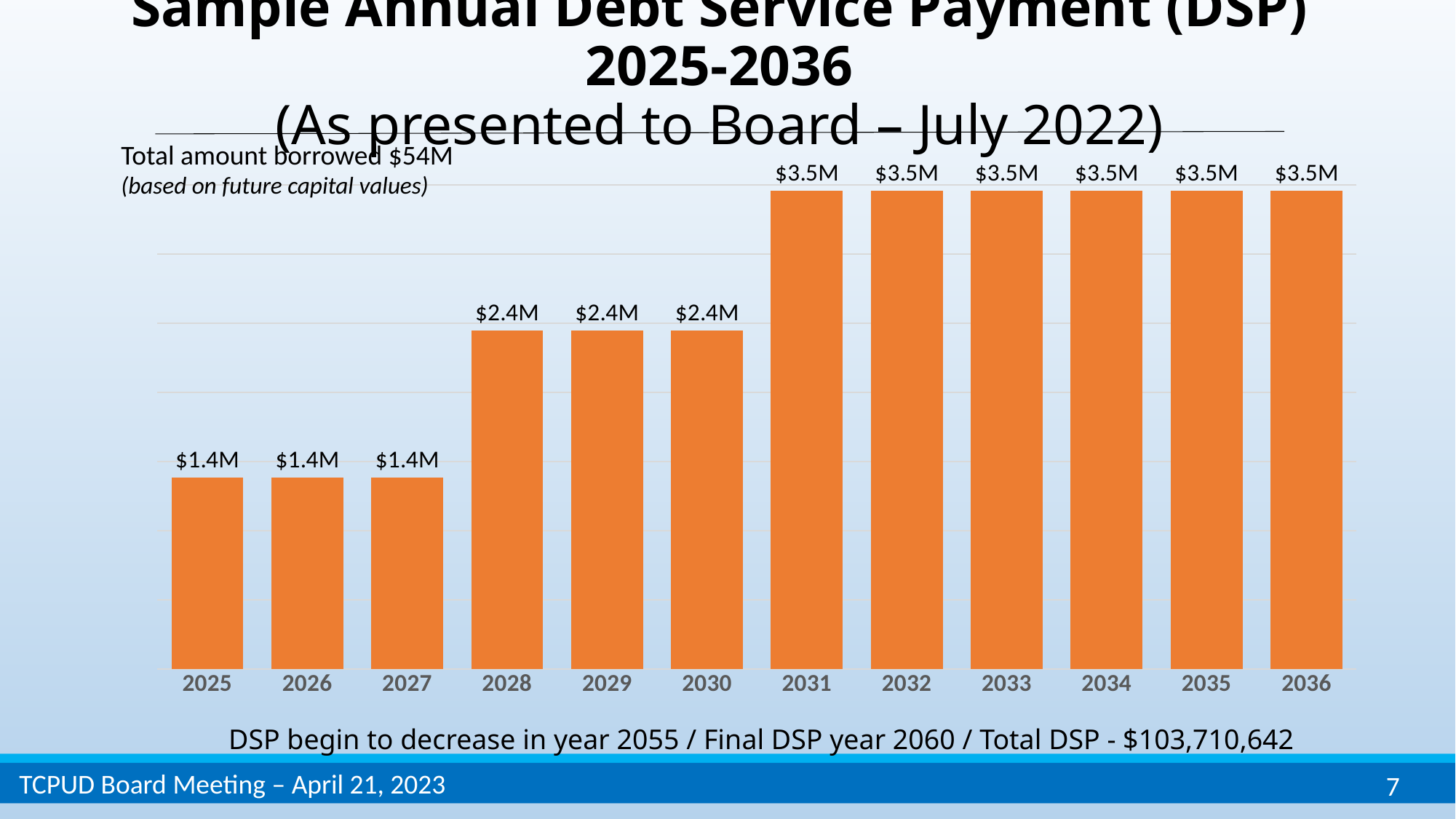
What is the annual debt service payment shown for 2031? $3.5M How many years on the chart have a payment of $3.5M? 6 Which is larger, the payment for 2030 or the payment for 2032? 2032 What is the annual debt service payment shown for 2025? $1.4M How many years are plotted on the chart? 12 What is the difference between the payment for 2028 and the payment for 2027? $1.0M Which year has the lowest debt service payment among 2027, 2028 and 2031? 2027 What is the annual debt service payment shown for 2029? $2.4M What is the annual debt service payment shown for 2036? $3.5M Do the payment values rise or fall from 2025 to 2036? Rise What is the difference between the payment for 2031 and the payment for 2025? $2.1M What kind of chart is shown on the slide? Bar chart